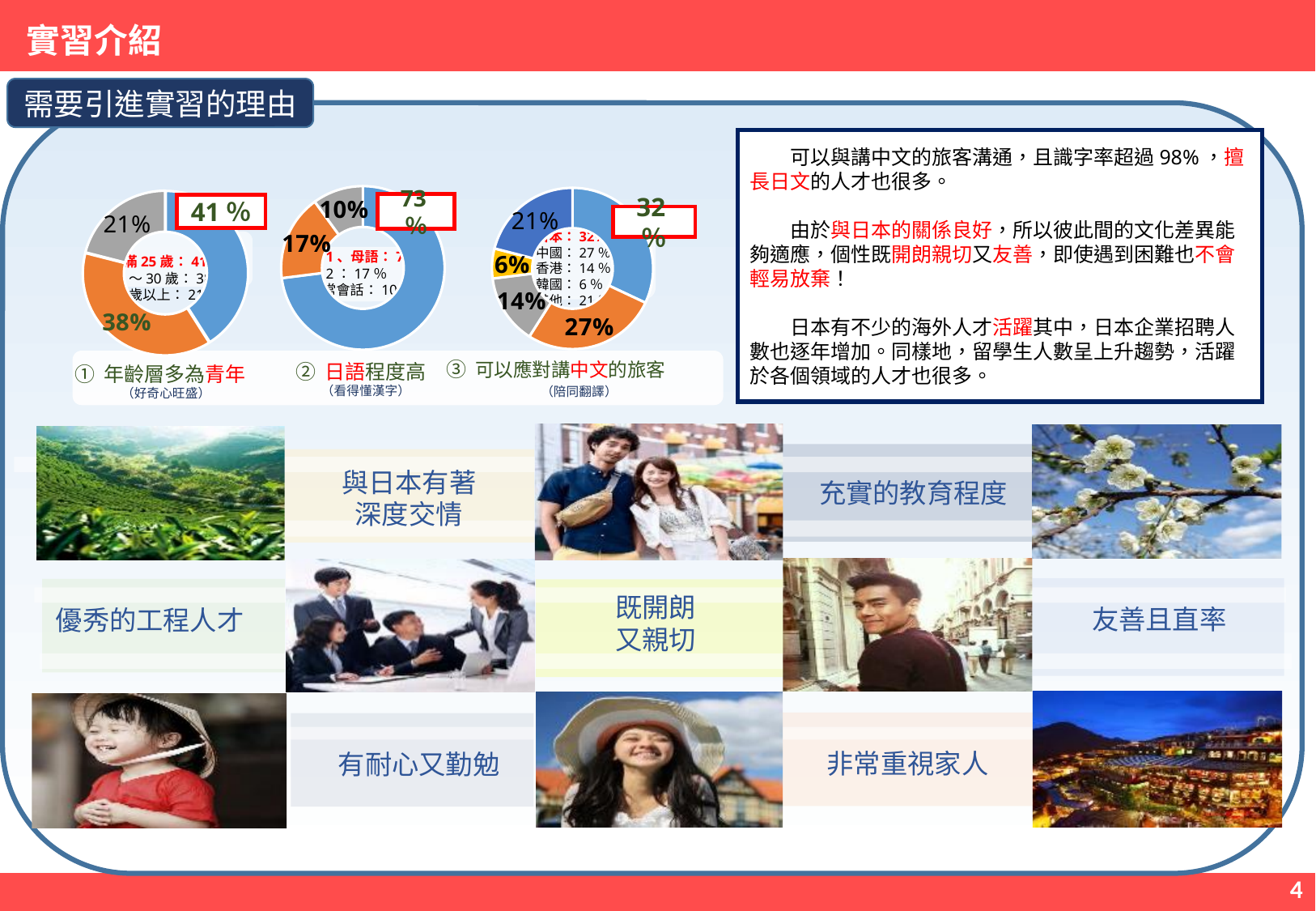
In the third chart (③ 可以應對講中文的旅客), what percentage is shown for 韓國? 6 % What kind of chart is used for the three charts on the left side of the slide? Donut (pie) chart In the first chart (① 年齡層多為青年), what is the smallest percentage shown? 21% In the first chart (① 年齡層多為青年), how many slices does the donut have? 3 In the second chart (② 日語程度高), what percentage is shown for 母語 (native speakers)? 73% In the third chart (③ 可以應對講中文的旅客), what percentage is shown for 中國? 27 % In the first chart (① 年齡層多為青年), what is the difference between the 41% slice and the 38% slice? 3% In the third chart (③ 可以應對講中文的旅客), which is larger, the value for 香港 or the value for 韓國? 香港 In the first chart (① 年齡層多為青年), what is the largest percentage shown? 41 % In the third chart (③ 可以應對講中文的旅客), how many slices does the donut have? 5 In the second chart (② 日語程度高), how many slices does the donut have? 3 In the second chart (② 日語程度高), what is the smallest percentage shown? 10%